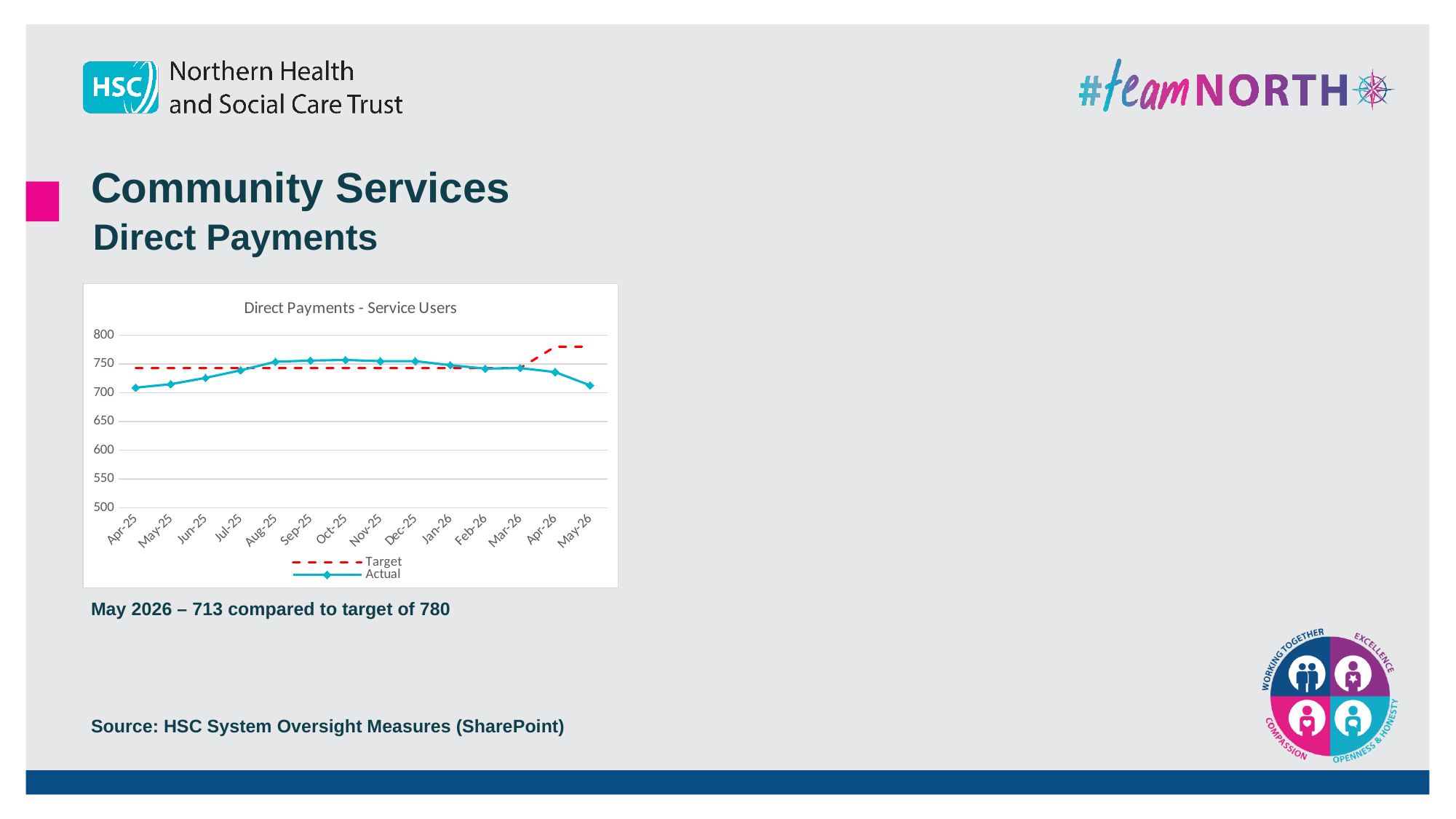
Is the actual value for Dec-25 greater or less than 700? greater Is the actual value for Apr-25 greater or less than 750? less How many months are plotted on the x axis of the chart? 14 Is the target value for Apr-26 greater or less than 750? greater Does the actual series rise or fall from Dec-25 to May-26? Fall Which is higher: the actual value for Apr-25 or the actual value for Oct-25? Oct-25 In May-26, which is larger: the target or the actual value? Target In May-26, what is the difference between the target and the actual value? 67 What is the actual value for May-26 in the Direct Payments - Service Users chart? 713 What is the target value for May-26 in the Direct Payments - Service Users chart? 780 What kind of chart is shown on the slide? Line chart How many series does the chart legend list? 2